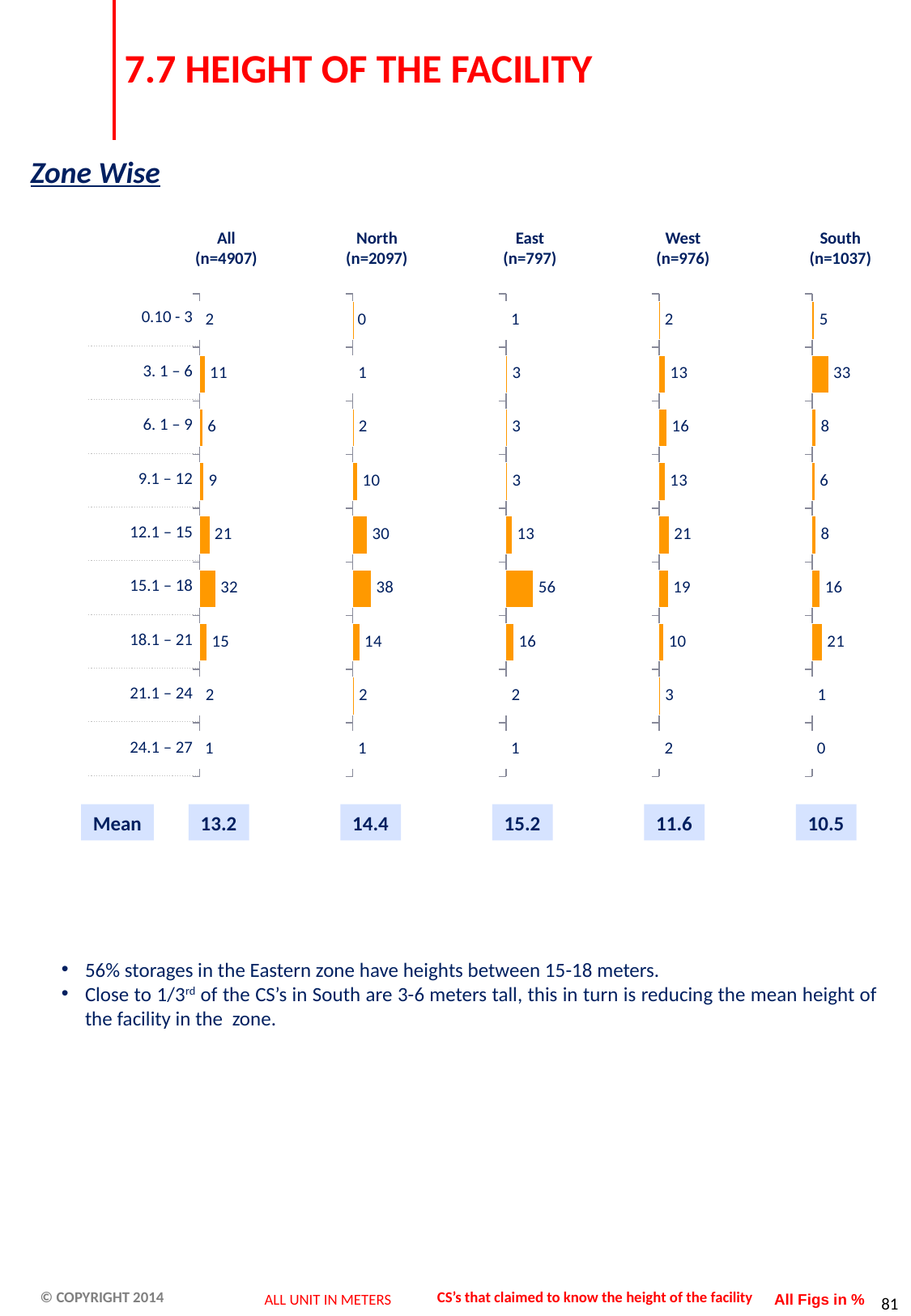
In the North (n=2097) chart, which category has the highest value? 15.1 – 18 In the East (n=797) chart, what is the value for the 15.1 – 18 category? 56 In the South (n=1037) chart, what is the value for the 3. 1 – 6 category? 33 In the West (n=976) chart, which is larger: the value for 12.1 – 15 or the value for 15.1 – 18? 12.1 – 15 Which zone chart has the highest mean value shown below it? East What is the mean value shown below the South (n=1037) chart? 10.5 How many height categories are shown in each chart? 9 What kind of chart is used for the All (n=4907) data? bar chart In the South (n=1037) chart, which category has the lowest value? 24.1 – 27 In the All (n=4907) chart, what is the difference between the 15.1 – 18 value and the 12.1 – 15 value? 11 In the North (n=2097) chart, what is the value for the 0.10 - 3 category? 0 In the West (n=976) chart, what is the value for the 6. 1 – 9 category? 16